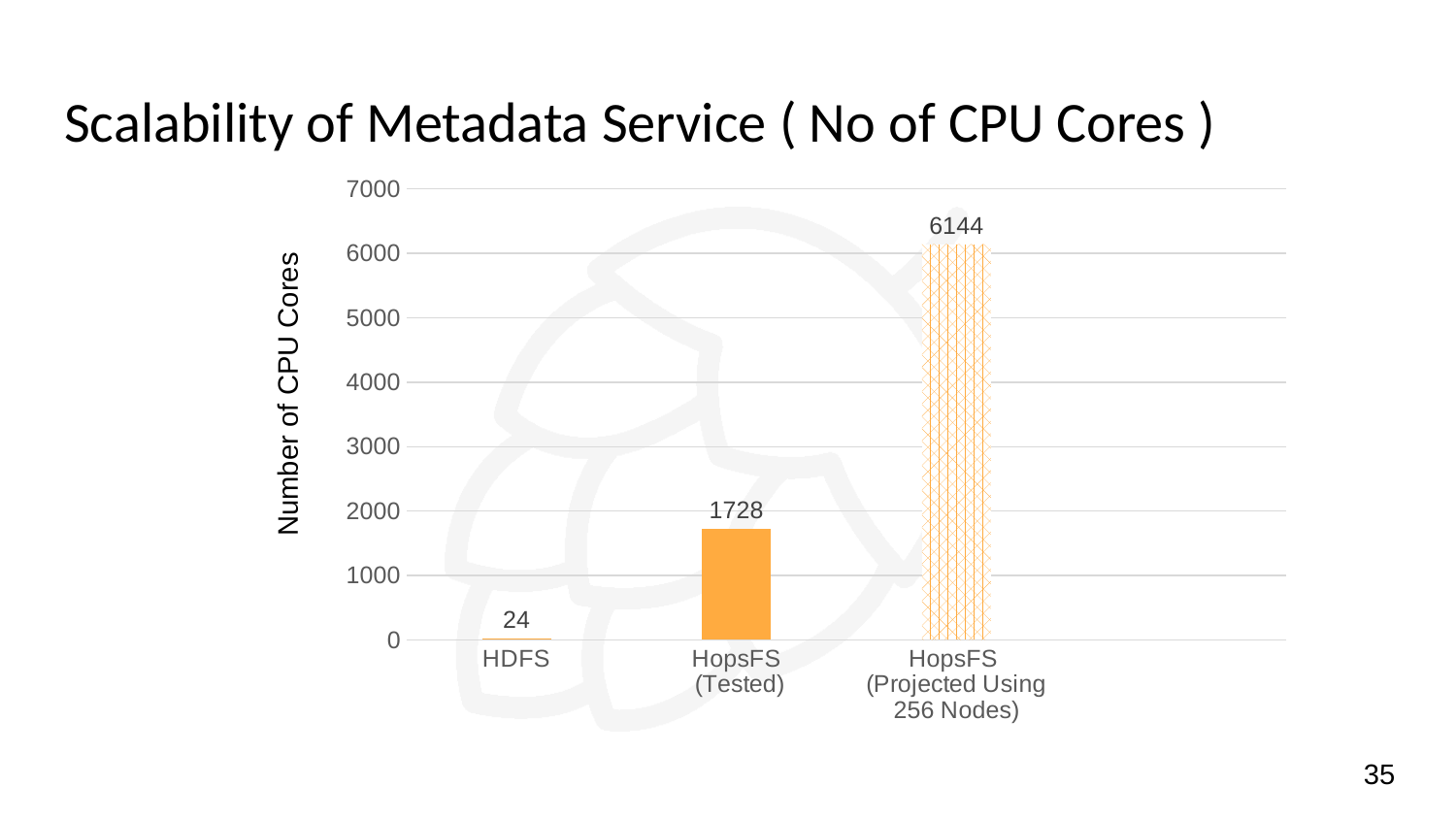
What is the number of CPU cores for HopsFS (Tested)? 1728 What is the number of CPU cores for HDFS? 24 What kind of chart is shown on the slide? bar chart Which category has the lowest number of CPU cores? HDFS How many categories are shown on the x axis? 3 Which category has the highest number of CPU cores? HopsFS (Projected Using 256 Nodes) Which has more CPU cores, HDFS or HopsFS (Tested)? HopsFS (Tested) What is the title of the chart? Scalability of Metadata Service ( No of CPU Cores ) What is the number of CPU cores for HopsFS (Projected Using 256 Nodes)? 6144 What is the difference in CPU cores between HopsFS (Tested) and HDFS? 1704 Is the value for HopsFS (Projected Using 256 Nodes) greater or less than 6000? greater What is the difference in CPU cores between HopsFS (Projected Using 256 Nodes) and HopsFS (Tested)? 4416